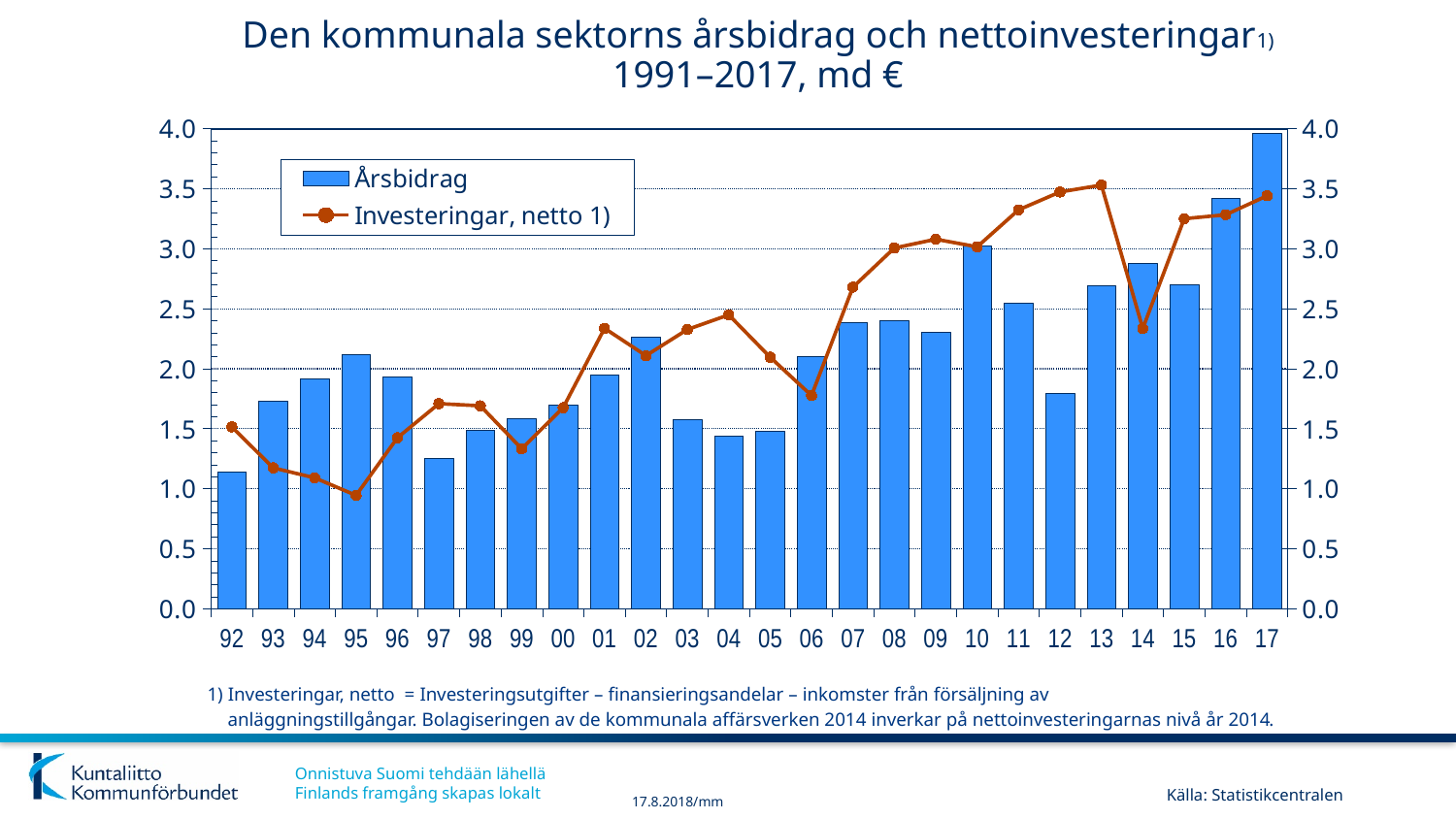
How many years are shown on the x axis? 26 Is the Årsbidrag value for 17 greater or less than 3.5? greater In 2014 (14), which is larger: Årsbidrag or Investeringar, netto? Årsbidrag In which year is the Investeringar, netto line at its lowest? 95 In 2001 (01), which is larger: Årsbidrag or Investeringar, netto? Investeringar, netto Does the Investeringar, netto line rise or fall from 06 to 13? rise Which year has the highest Årsbidrag bar? 17 Which year has the lowest Årsbidrag bar? 92 How many series does the legend list? 2 What kind of chart is this? Combined bar and line chart Is the Investeringar, netto value for 14 greater or less than 2.5? less Is the Årsbidrag value for 12 greater or less than 2.0? less